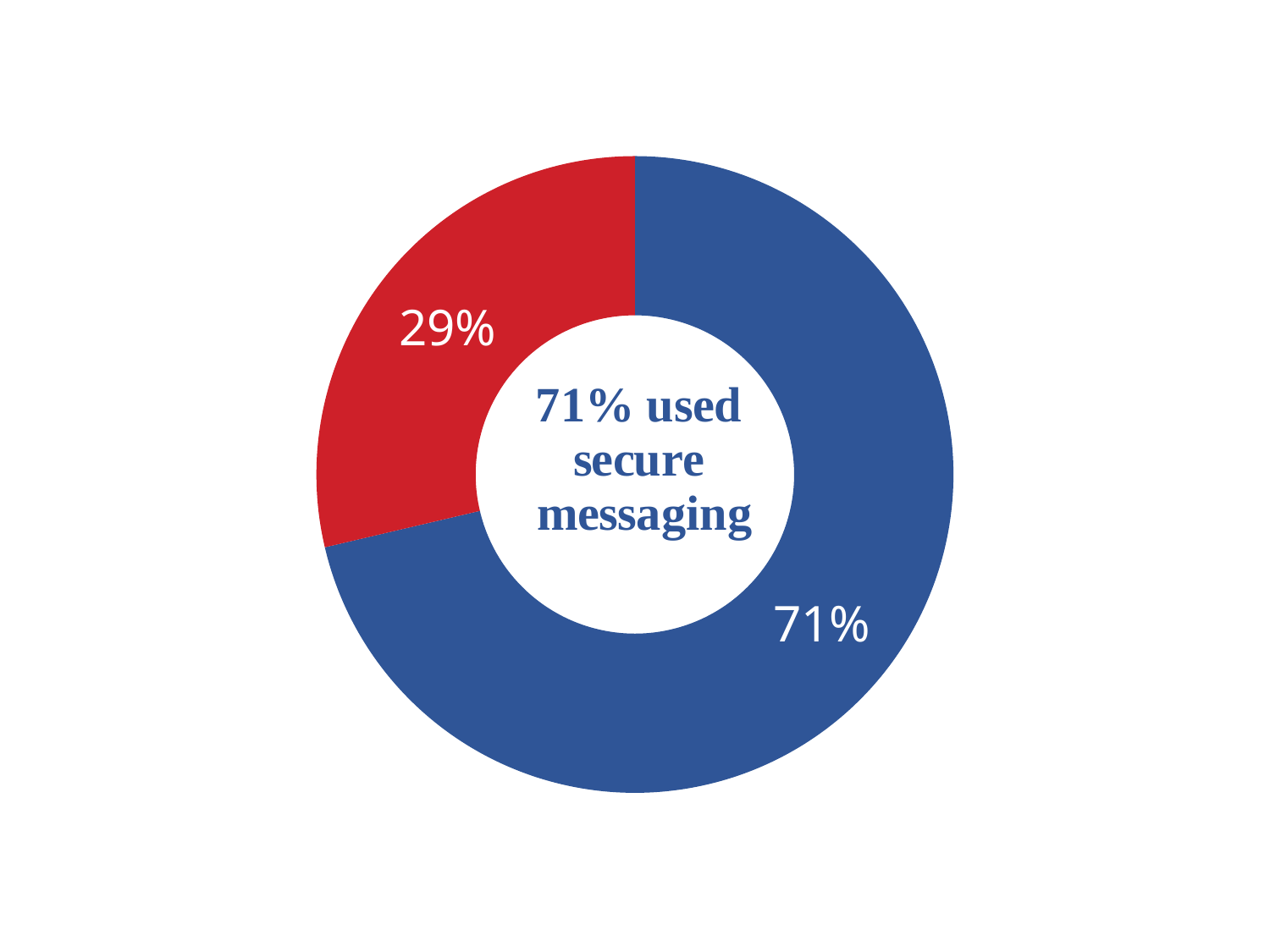
What kind of chart is shown on the slide? Doughnut (pie) chart Which slice of the doughnut chart is the largest? The blue slice (71%) What is the total of the two slices shown on the doughnut chart? 100% Which slice of the doughnut chart is the smallest? The red slice (29%) How many slices does the doughnut chart have? 2 What text is written in the centre of the doughnut chart? 71% used secure messaging What is the difference in percentage points between the blue slice and the red slice? 42 percentage points What share of the doughnut chart does the blue slice represent? 71% Which is larger, the blue slice or the red slice? The blue slice What share of the doughnut chart does the red slice represent? 29% What colour is the slice labelled 29%? Red